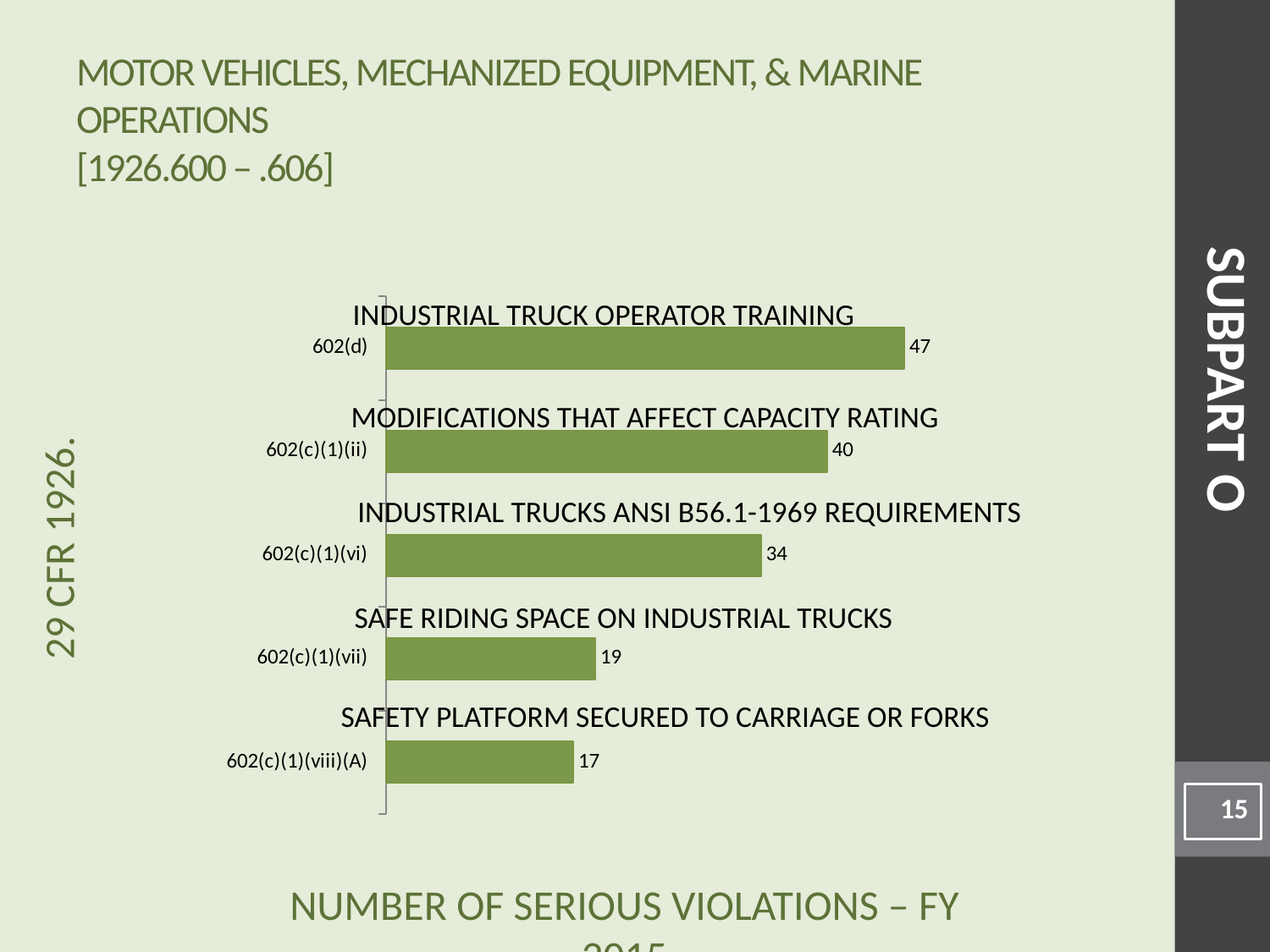
What is the difference in serious violations between 602(c)(1)(vi) and 602(c)(1)(vii)? 15 Which standard has the highest number of serious violations? 602(d) What is the number of serious violations for 602(d), Industrial Truck Operator Training? 47 What is the number of serious violations for 602(c)(1)(ii), Modifications That Affect Capacity Rating? 40 Which has more serious violations, 602(c)(1)(vii) or 602(c)(1)(viii)(A)? 602(c)(1)(vii) What is the number of serious violations for 602(c)(1)(viii)(A), Safety Platform Secured to Carriage or Forks? 17 What is the number of serious violations for 602(c)(1)(vii), Safe Riding Space on Industrial Trucks? 19 What is the difference in serious violations between 602(d) and 602(c)(1)(ii)? 7 How many standards are shown in the chart? 5 What type of chart is shown on the slide? Bar chart Which standard has the lowest number of serious violations? 602(c)(1)(viii)(A) What is the number of serious violations for 602(c)(1)(vi), Industrial Trucks ANSI B56.1-1969 Requirements? 34